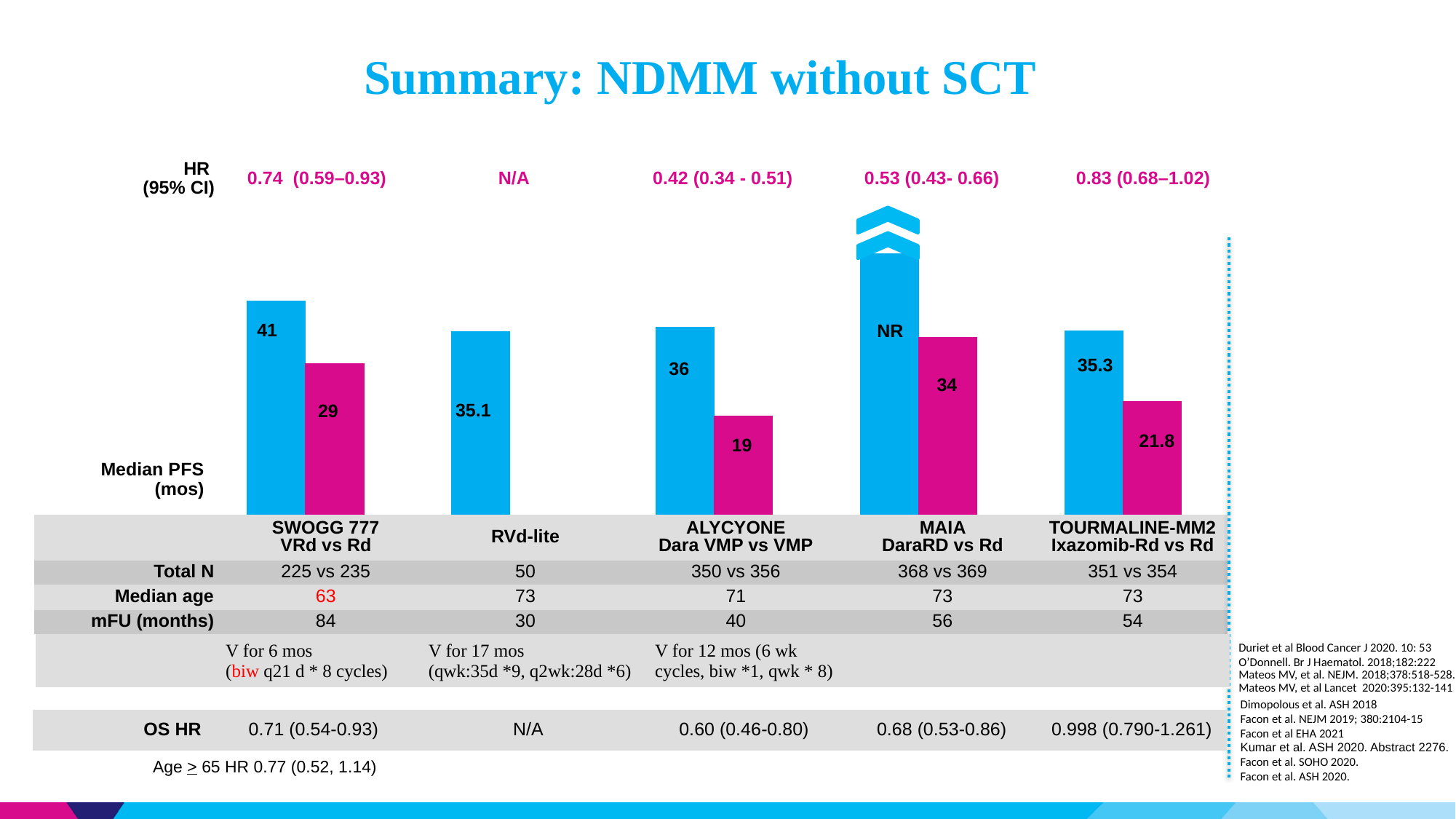
What kind of chart is used to show median PFS on this slide? Bar chart What is the median PFS in months for the Rd arm (magenta bar) in the TOURMALINE-MM2 trial? 21.8 What is the median PFS in months shown for the RVd-lite trial? 35.1 What label is shown on the DaraRD bar (blue bar) in the MAIA trial? NR How many trials are shown along the x axis of the chart? 5 What is the median PFS in months for the Rd arm (magenta bar) in the SWOGG 777 trial? 29 Which has the larger median PFS: the Rd arm in SWOGG 777 or the VMP arm in ALYCYONE? Rd arm in SWOGG 777 Among the magenta control-arm bars with numeric labels, which trial has the lowest median PFS? ALYCYONE What is the median PFS in months for the VMP control arm (magenta bar) in the ALYCYONE trial? 19 What is the difference in median PFS (months) between the Ixazomib-Rd and Rd arms in the TOURMALINE-MM2 trial? 13.5 What is the difference in median PFS (months) between the Dara VMP and VMP arms in the ALYCYONE trial? 17 What is the median PFS in months for the VRd arm (blue bar) in the SWOGG 777 trial? 41